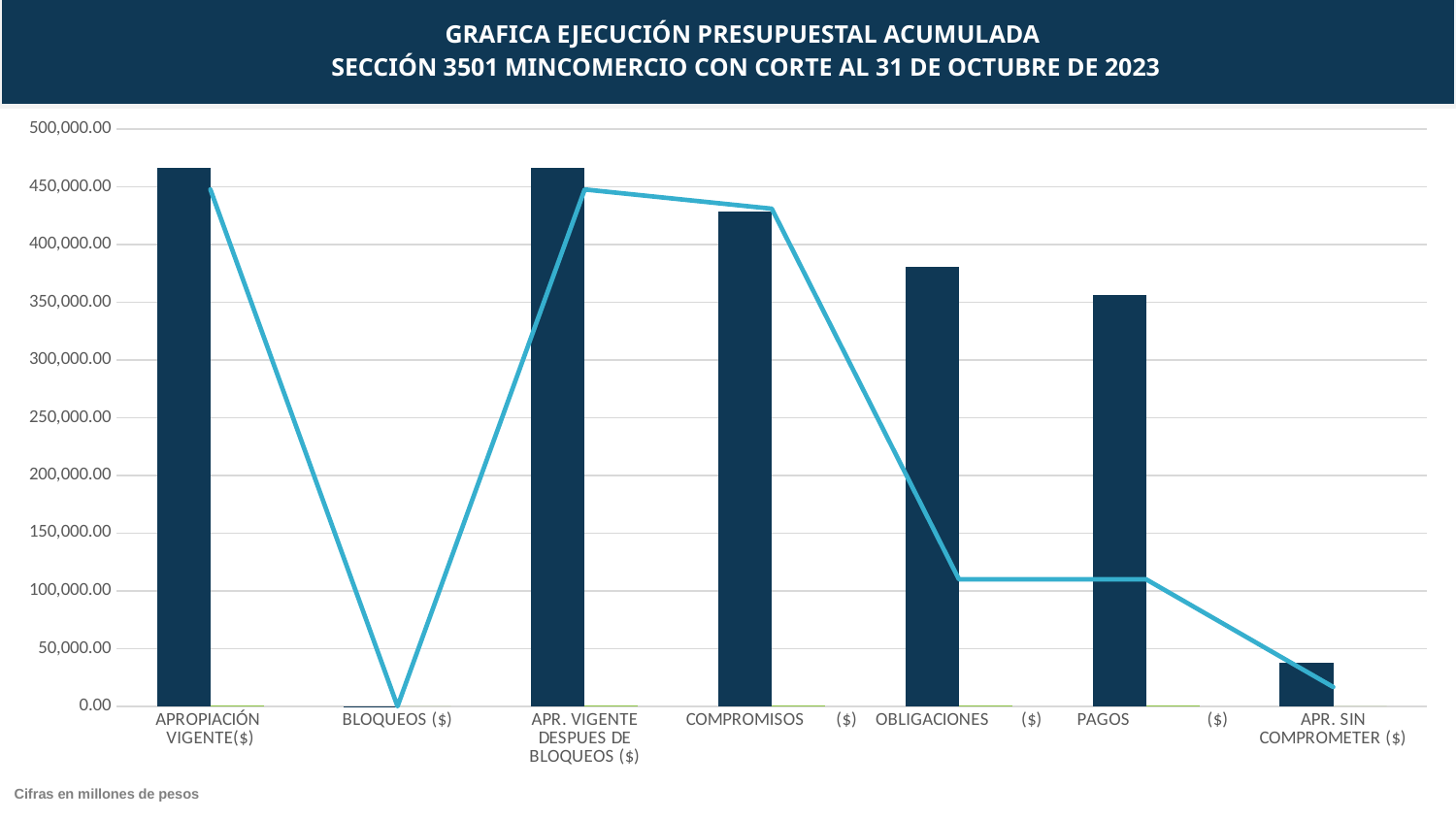
Is the bar for COMPROMISOS ($) greater or less than 400,000.00? greater Is the line value for OBLIGACIONES ($) greater or less than 150,000.00? less Is the bar for APROPIACIÓN VIGENTE($) greater or less than 450,000.00? greater What kind of chart is shown on the slide? A bar chart combined with a line Which bar is taller, OBLIGACIONES ($) or PAGOS ($)? OBLIGACIONES ($) According to the note below the chart, in what units are the figures expressed? Millones de pesos Do the bars rise or fall from COMPROMISOS ($) to APR. SIN COMPROMETER ($)? fall Which category has the lowest bar in the chart? BLOQUEOS ($) Which bar is taller, COMPROMISOS ($) or OBLIGACIONES ($)? COMPROMISOS ($) How many categories are shown on the x axis of the chart? 7